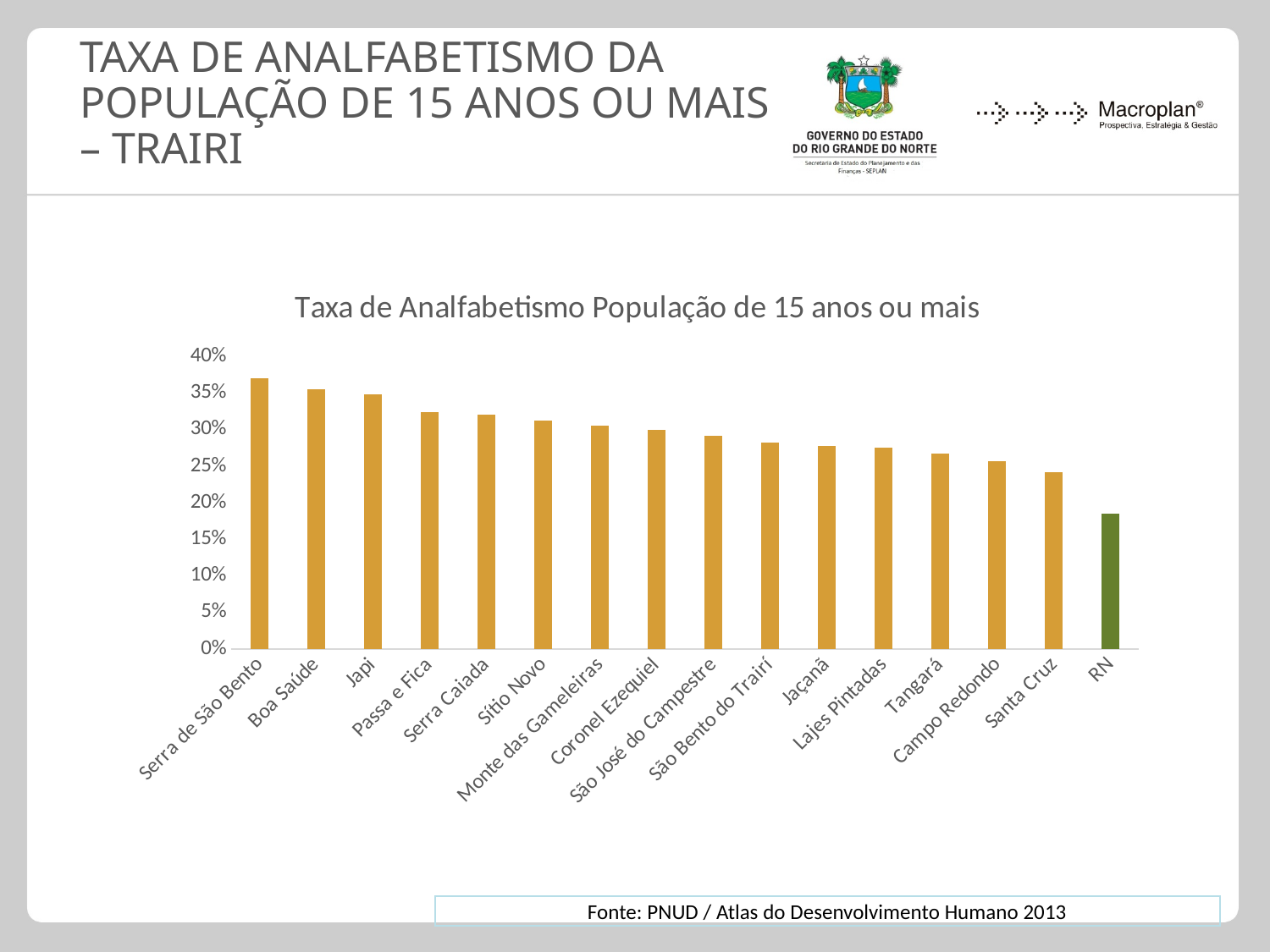
Which category has the lowest illiteracy rate in the chart? RN Is the value for Santa Cruz greater or less than 25%? less Is the value for Passa e Fica greater or less than 30%? greater Do the values rise or fall from left to right along the x axis? fall Which has a higher illiteracy rate, Serra de São Bento or Santa Cruz? Serra de São Bento What is the title of the chart? Taxa de Analfabetismo População de 15 anos ou mais Is the value for Serra de São Bento greater or less than 35%? greater Which category has the highest illiteracy rate in the chart? Serra de São Bento What kind of chart is shown on the slide? bar chart How many categories are plotted on the x axis? 16